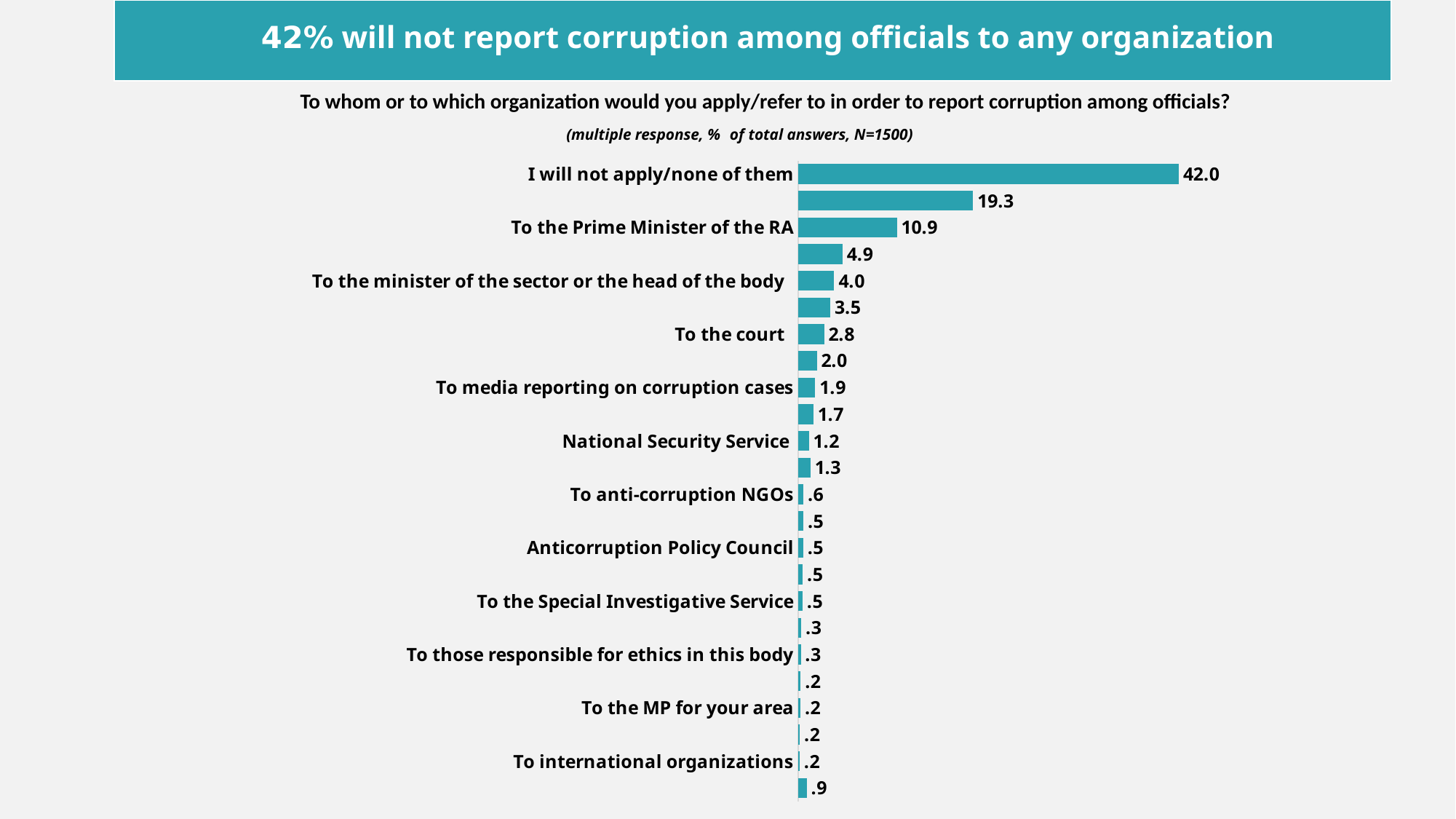
What is the value for "To media reporting on corruption cases"? 1.9 What is the title shown in the banner at the top of the slide? 42% will not report corruption among officials to any organization What is the value for "To the court"? 2.8 What is the value for "To the Prime Minister of the RA"? 10.9 What kind of chart is shown on the slide? bar chart What is the value for "I will not apply/none of them"? 42.0 Which is larger, the value for "To the court" or the value for "To media reporting on corruption cases"? To the court What is the difference between the values for "I will not apply/none of them" and "To the Prime Minister of the RA"? 31.1 What is the value for "National Security Service"? 1.2 Which category has the highest value? I will not apply/none of them What is the value for "To anti-corruption NGOs"? .6 What is the value for "To the minister of the sector or the head of the body"? 4.0